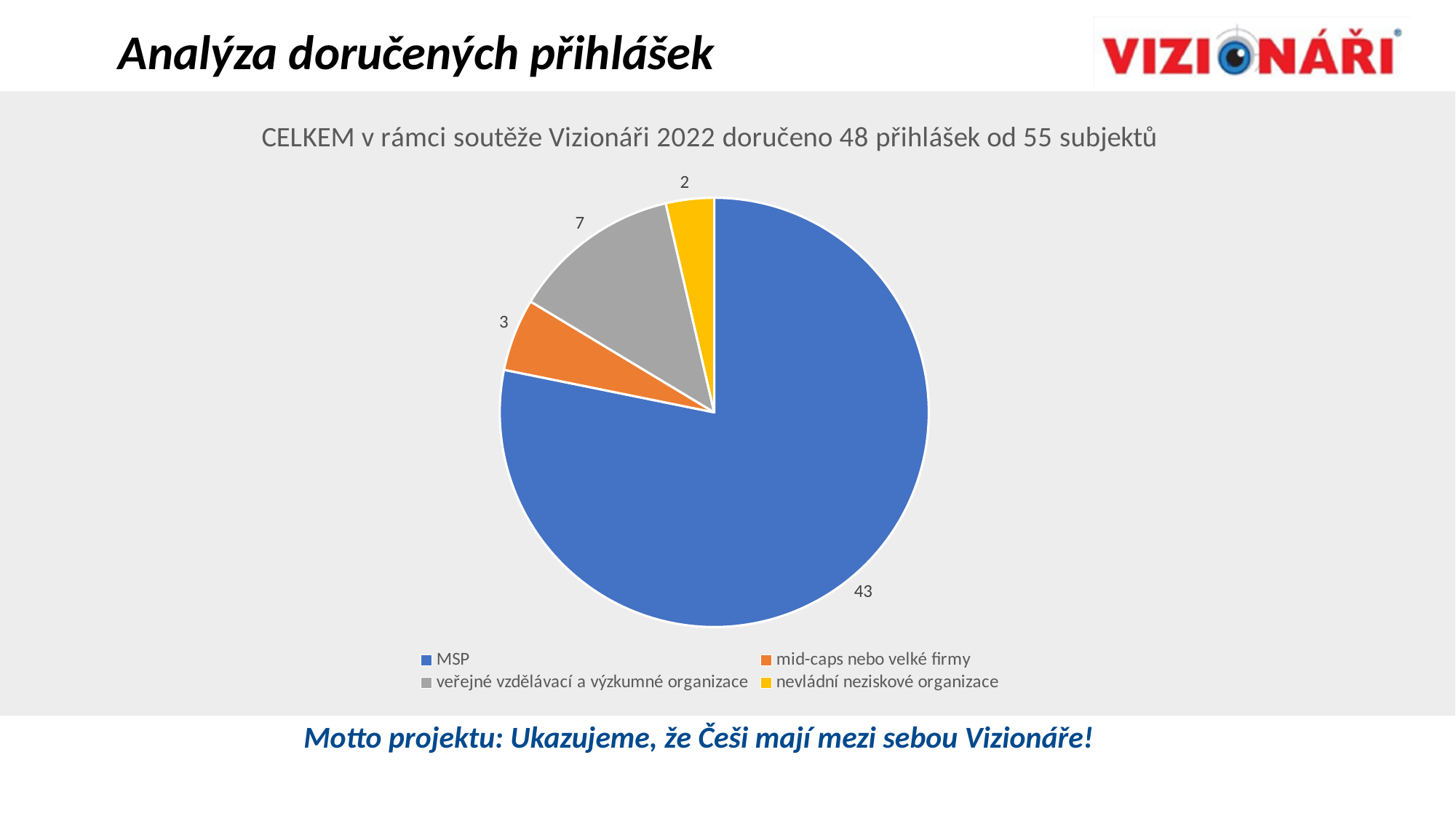
Which category has the largest slice of the pie? MSP What is the total of all slices in the pie chart? 55 How many categories does the pie chart show? 4 What is the difference between the values for MSP and veřejné vzdělávací a výzkumné organizace? 36 What is the value for mid-caps nebo velké firmy? 3 What is the value for veřejné vzdělávací a výzkumné organizace? 7 What colour is the slice for MSP? blue What is the value for nevládní neziskové organizace? 2 Which is larger: the value for mid-caps nebo velké firmy or the value for veřejné vzdělávací a výzkumné organizace? veřejné vzdělávací a výzkumné organizace What is the value for MSP in the pie chart? 43 What kind of chart is shown on the slide? pie chart Which category has the smallest slice of the pie? nevládní neziskové organizace